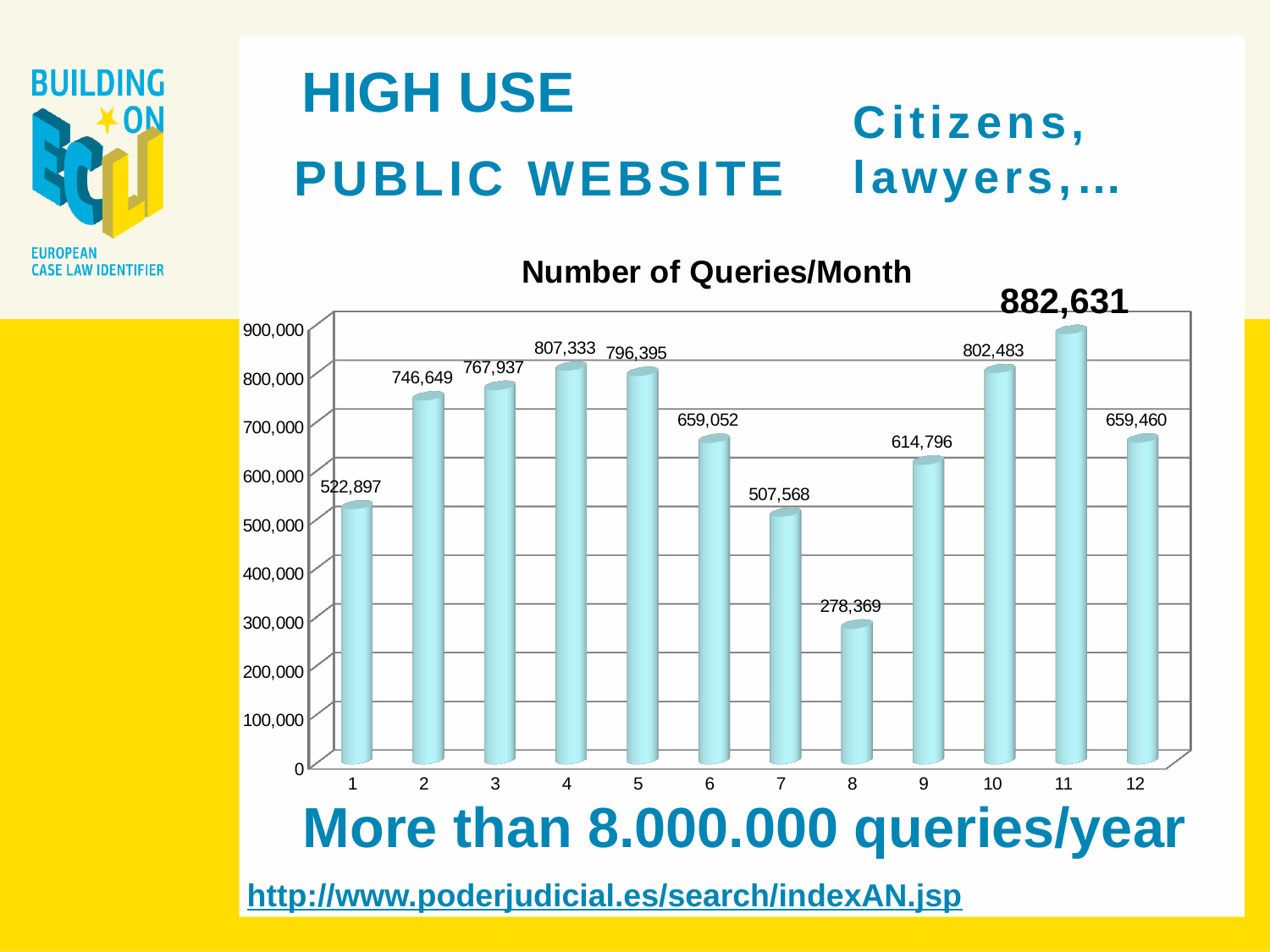
What kind of chart is used to show the number of queries per month? bar chart How many months are shown on the x axis of the chart? 12 What is the difference between the number of queries in month 11 and month 8? 604,262 What is the title of the chart? Number of Queries/Month What is the number of queries in month 1? 522,897 Which month has the highest number of queries? 11 Which month has the lowest number of queries? 8 What is the number of queries in month 11? 882,631 What is the difference between the number of queries in month 2 and month 1? 223,752 What is the number of queries in month 8? 278,369 Which month has more queries, month 7 or month 9? 9 Is the number of queries in month 8 greater or less than 300,000? less